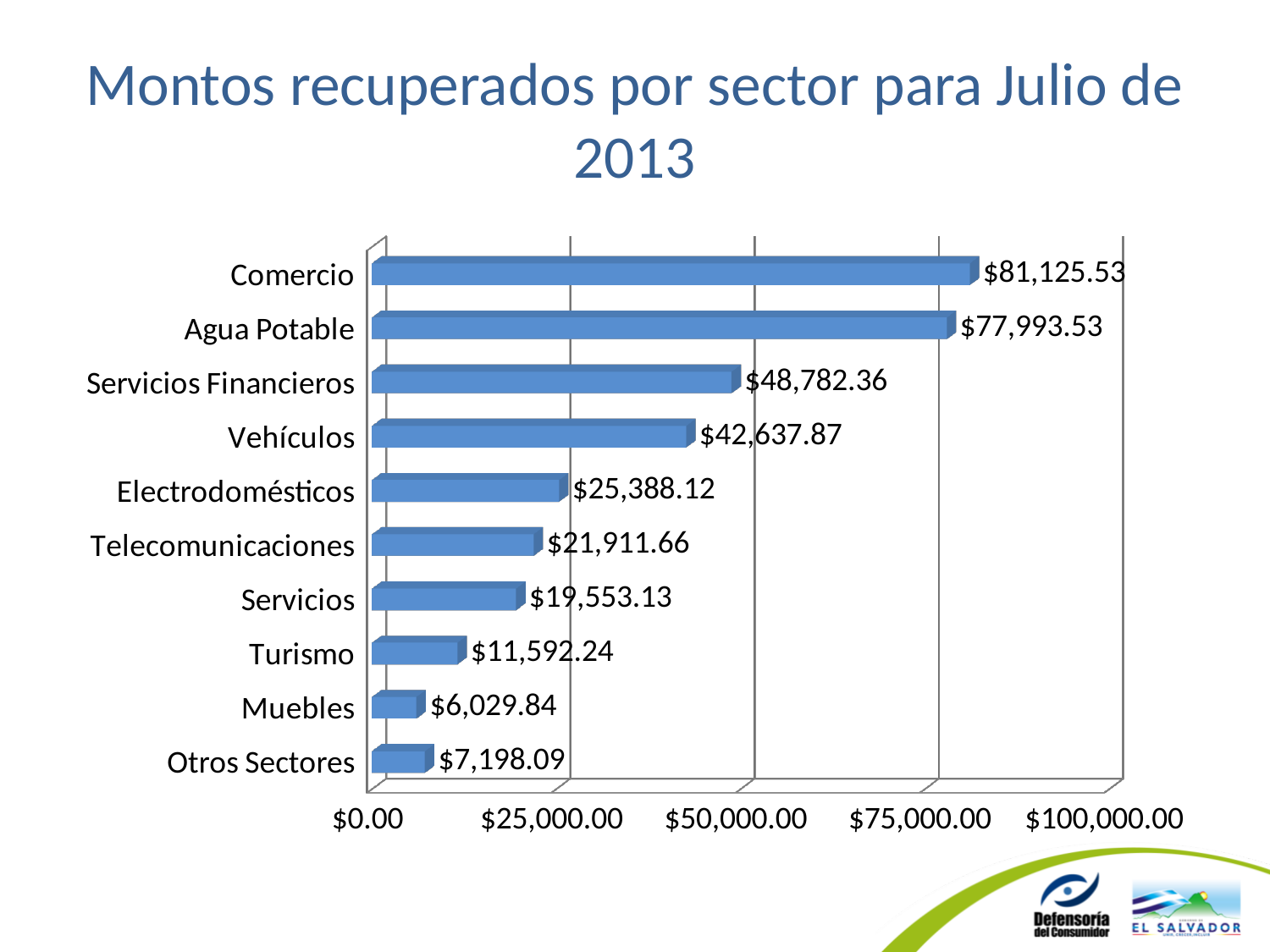
Which sector has the lowest recovered amount? Muebles What is the value for Comercio? $81,125.53 What is the difference between the values for Otros Sectores and Muebles? $1,168.25 What is the value for Telecomunicaciones? $21,911.66 Which is larger, the value for Electrodomésticos or the value for Servicios? Electrodomésticos What is the difference between the values for Servicios Financieros and Vehículos? $6,144.49 Which sector has the highest recovered amount? Comercio What is the value for Turismo? $11,592.24 What kind of chart is shown on the slide? bar chart What is the difference between the values for Comercio and Agua Potable? $3,132.00 How many sectors are shown in the chart? 10 Is the value for Vehículos greater or less than $50,000.00? less